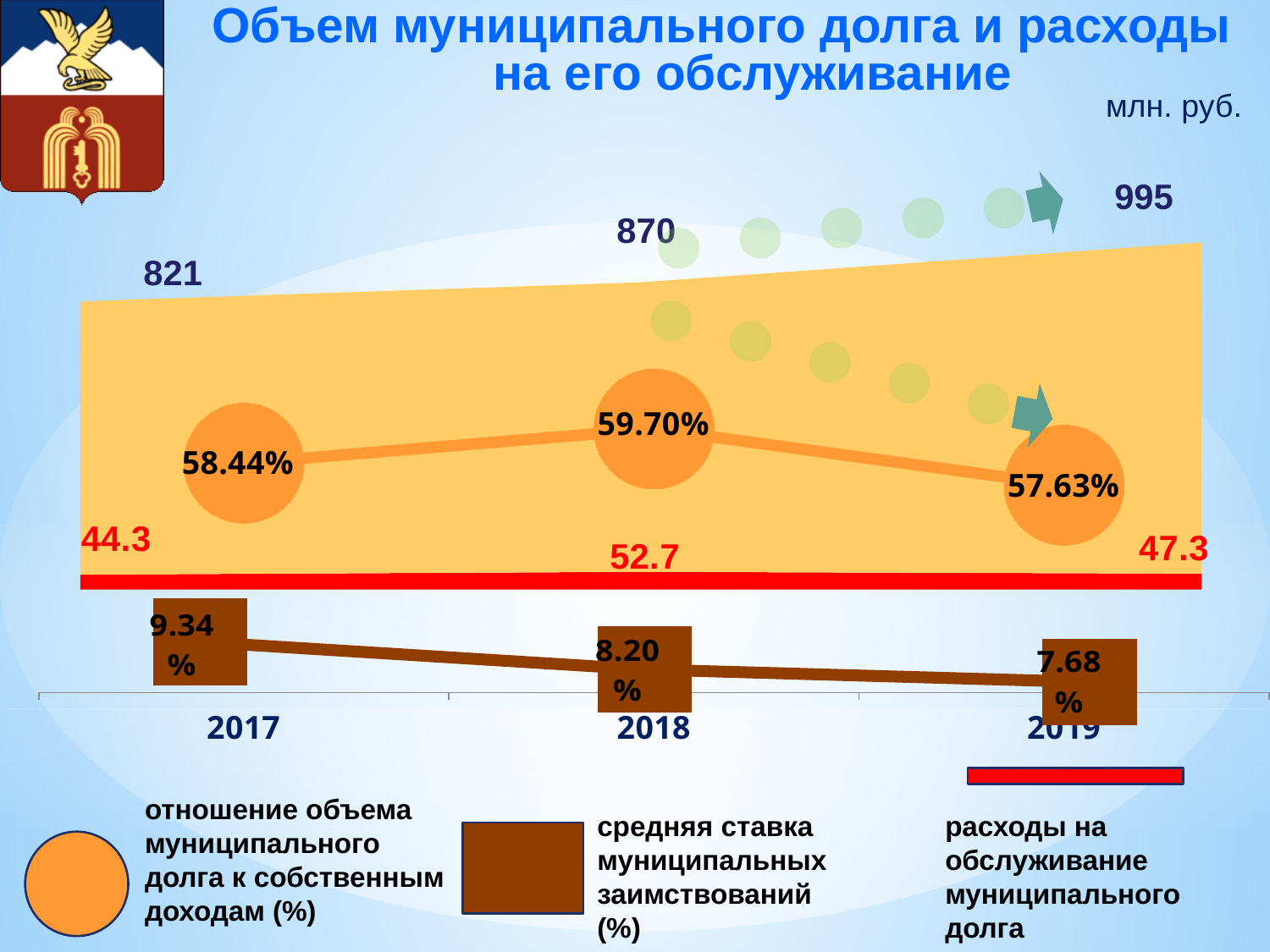
В каком году объем муниципального долга был наибольшим? 2019 Сколько лет показано на оси x диаграммы? 3 Каков объем муниципального долга в 2017 году? 821 Каковы расходы на обслуживание муниципального долга в 2018 году? 52.7 Каково отношение объема муниципального долга к собственным доходам в 2018 году? 59.70% В каком году средняя ставка муниципальных заимствований была наименьшей? 2019 Как изменяется средняя ставка муниципальных заимствований с 2017 по 2019 год? снижается Каков объем муниципального долга в 2019 году? 995 На сколько млн. руб. объем муниципального долга в 2019 году больше, чем в 2017 году? 174 Какова средняя ставка муниципальных заимствований в 2019 году? 7.68% В каких единицах измерения приведен объем муниципального долга на слайде? млн. руб. Что больше: расходы на обслуживание муниципального долга в 2017 году или в 2019 году? 2019